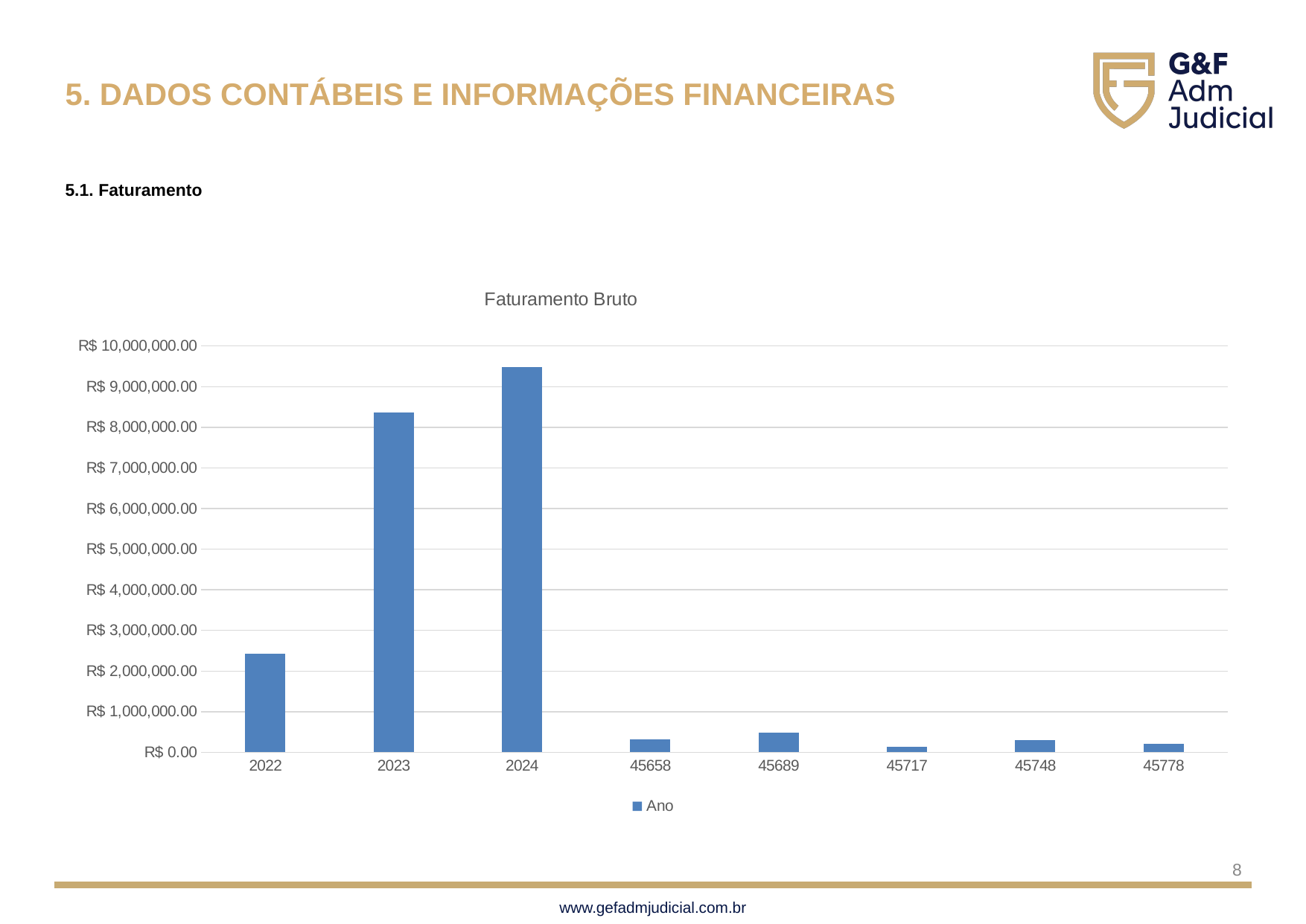
Which is larger, the value for 2023 or the value for 2022? 2023 How many series does the legend list? 1 Is the value for 45689 greater or less than R$ 1,000,000.00? less Which category has the lowest value? 45717 How many categories are shown on the x axis of the chart? 8 What is the title of the chart? Faturamento Bruto What kind of chart is shown on the slide? bar chart Is the value for 2024 greater or less than R$ 9,000,000.00? greater Which category has the highest value? 2024 What is the name of the series shown in the legend? Ano Do the values rise or fall from 2022 to 2024? rise Is the value for 2022 greater or less than R$ 3,000,000.00? less